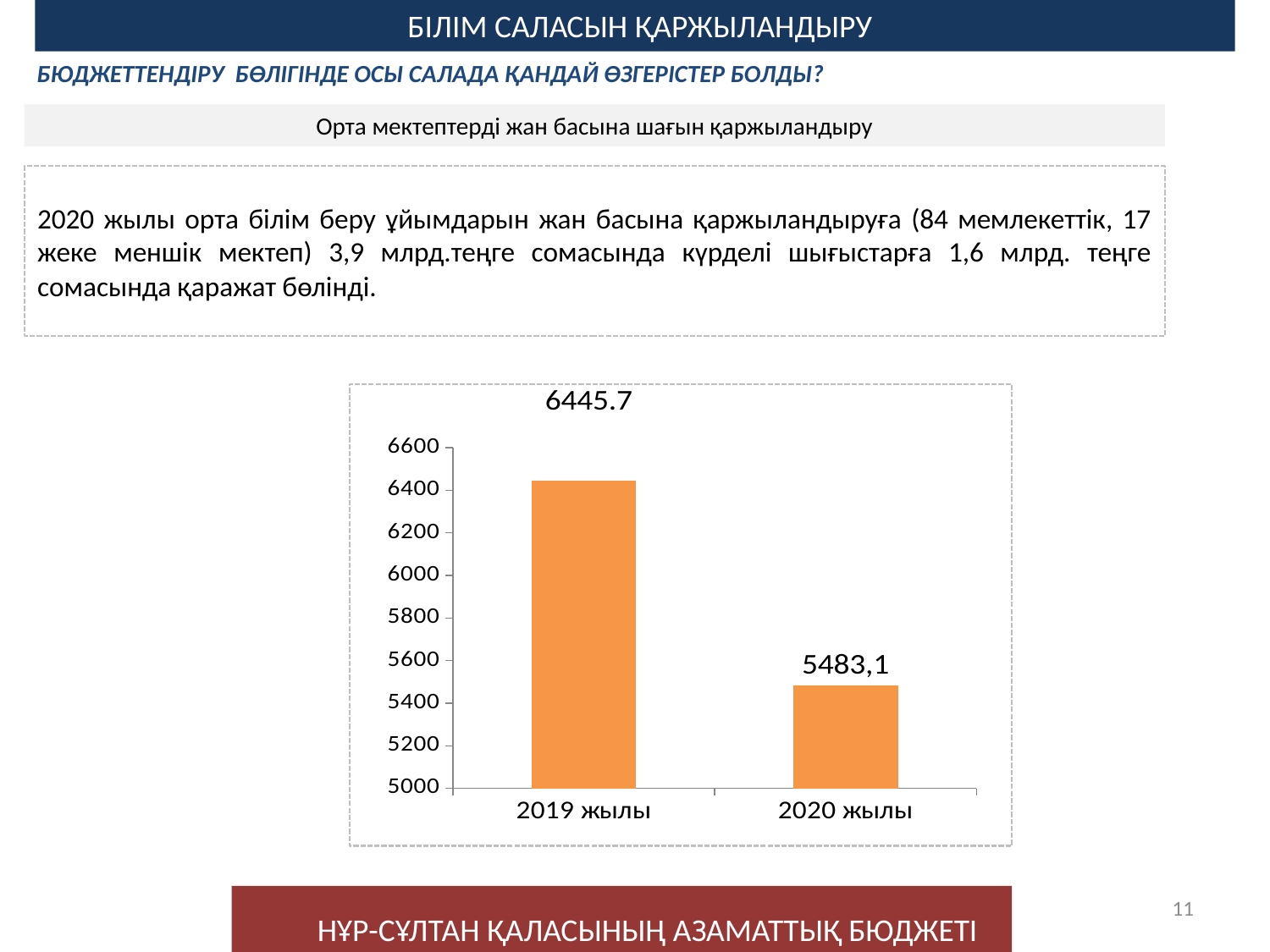
Is the value for 2020 жылы greater or less than 5600? less How many categories are shown on the x axis? 2 What colour are the bars in the chart? orange What is the value for 2020 жылы? 5483,1 Which year has the lowest value? 2020 жылы Which year has the highest value? 2019 жылы Is the value for 2019 жылы greater or less than 6200? greater Which is larger, the value for 2019 жылы or for 2020 жылы? 2019 жылы What is the value for 2019 жылы? 6445.7 What is the difference between the values for 2019 жылы and 2020 жылы? 962.6 What kind of chart is shown on the slide? bar chart Do the values rise or fall from 2019 жылы to 2020 жылы? fall